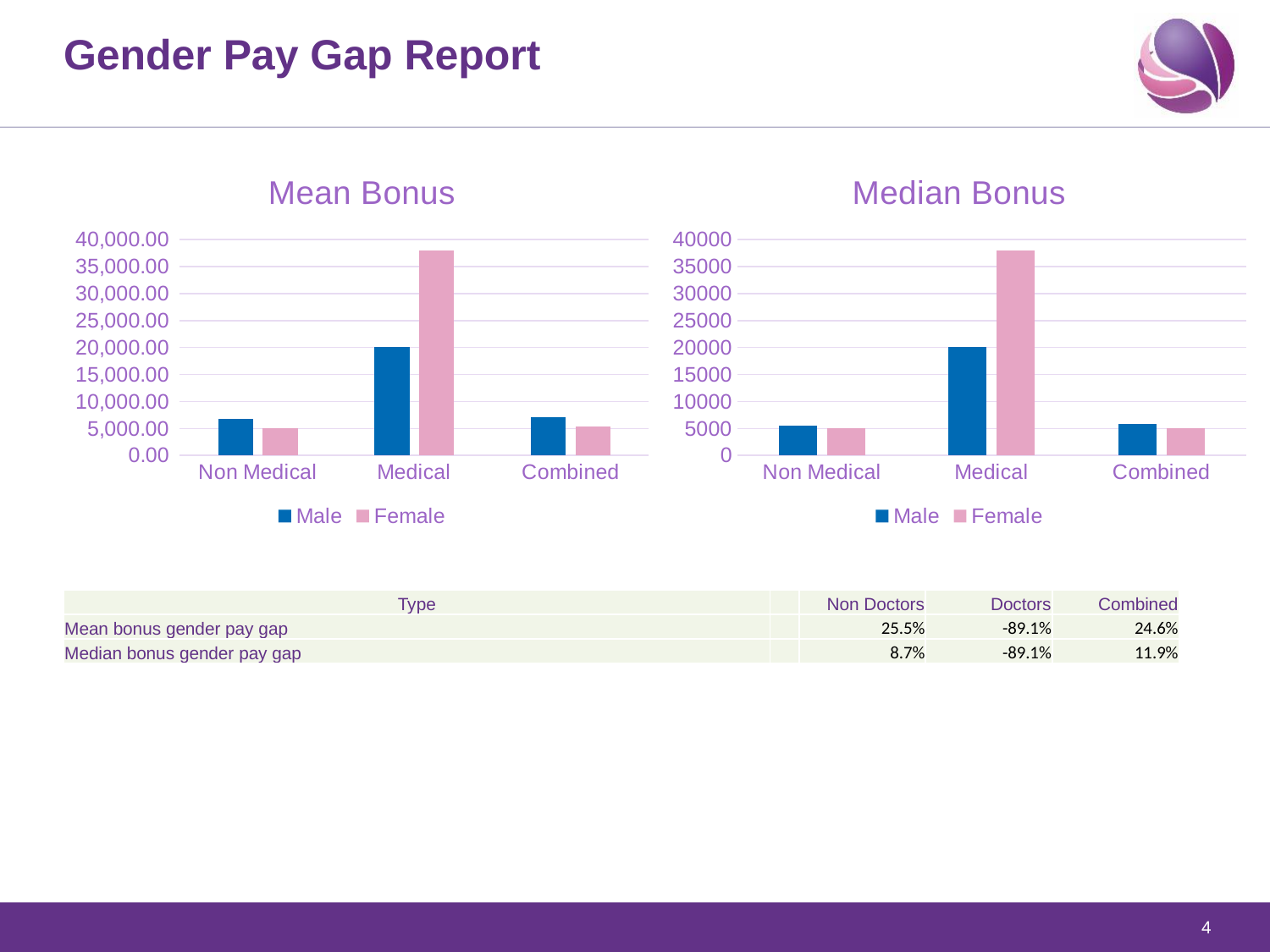
In the Median Bonus chart, which category has the lowest Male bar? Non Medical In the Median Bonus chart, is the Male value for Non Medical greater or less than 10000? less How many categories are shown on the x axis of the Median Bonus chart? 3 How many series does the legend of the Mean Bonus chart list? 2 In the Median Bonus chart, which is larger for Medical, the Male value or the Female value? Female What kind of chart is the Mean Bonus chart? bar chart In the Mean Bonus chart, which is larger for Non Medical, the Male value or the Female value? Male In the Mean Bonus chart, which category has the highest Female bar? Medical In the Mean Bonus chart, is the Female value for Medical greater or less than 35,000.00? greater What is the title of the chart on the left of the slide? Mean Bonus What are the two legend entries in the Median Bonus chart? Male, Female In the Mean Bonus chart, is the Male value for Medical greater or less than 15,000.00? greater